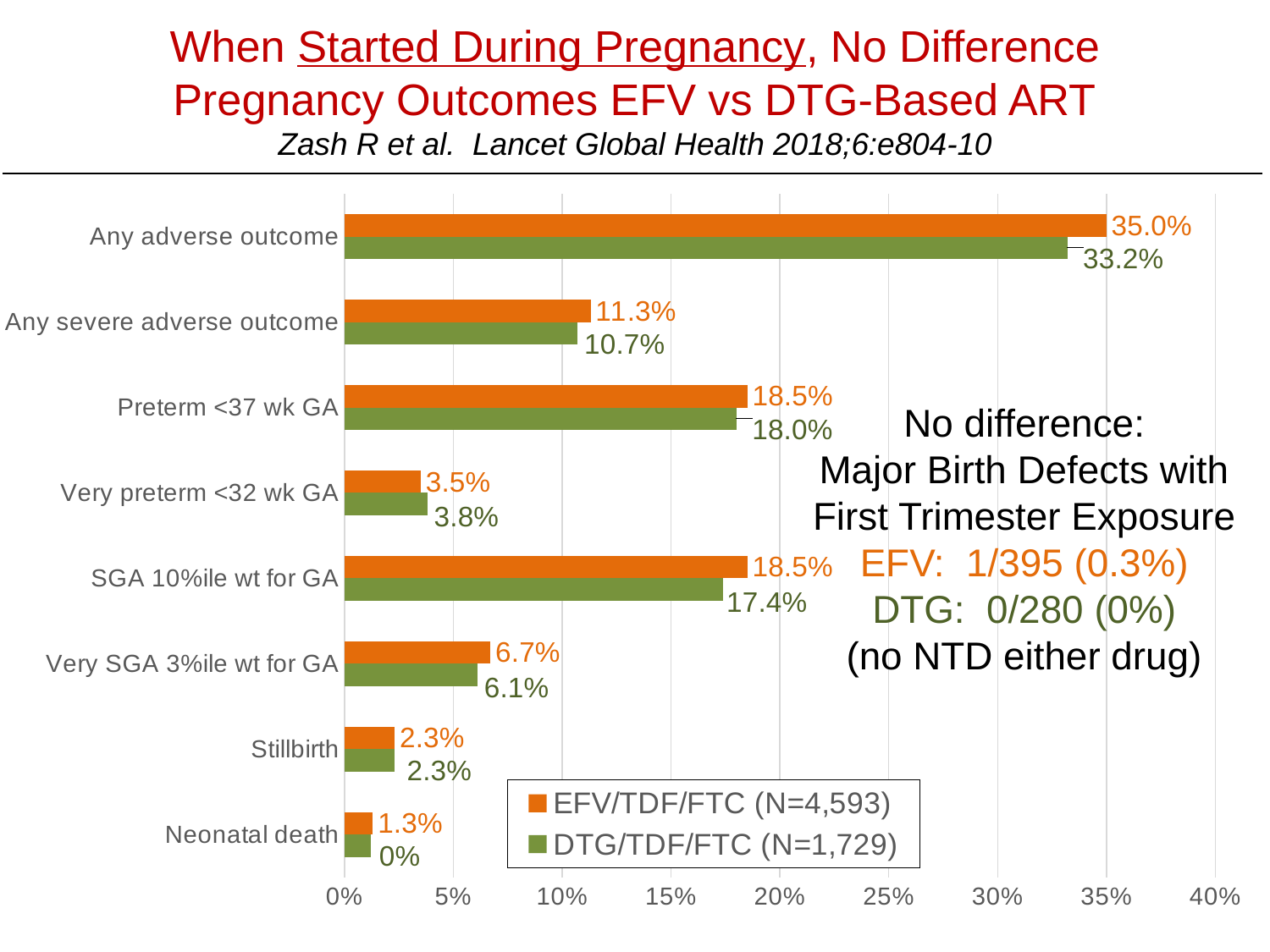
How many outcome categories are shown on the chart? 8 Which category has the lowest EFV/TDF/FTC value? Neonatal death What is the DTG/TDF/FTC value for Any severe adverse outcome? 10.7% What kind of chart is shown on the slide? Bar chart Which category has the highest EFV/TDF/FTC value? Any adverse outcome How many series does the legend list? 2 Is the DTG/TDF/FTC value for Preterm <37 wk GA greater or less than 15%? greater For Very preterm <32 wk GA, which series has the larger value, EFV/TDF/FTC or DTG/TDF/FTC? DTG/TDF/FTC What is the EFV/TDF/FTC value for Very SGA 3%ile wt for GA? 6.7% What is the difference between the EFV/TDF/FTC and DTG/TDF/FTC values for Any adverse outcome? 1.8% What is the EFV/TDF/FTC value for Any adverse outcome? 35.0% What is the DTG/TDF/FTC value for SGA 10%ile wt for GA? 17.4%